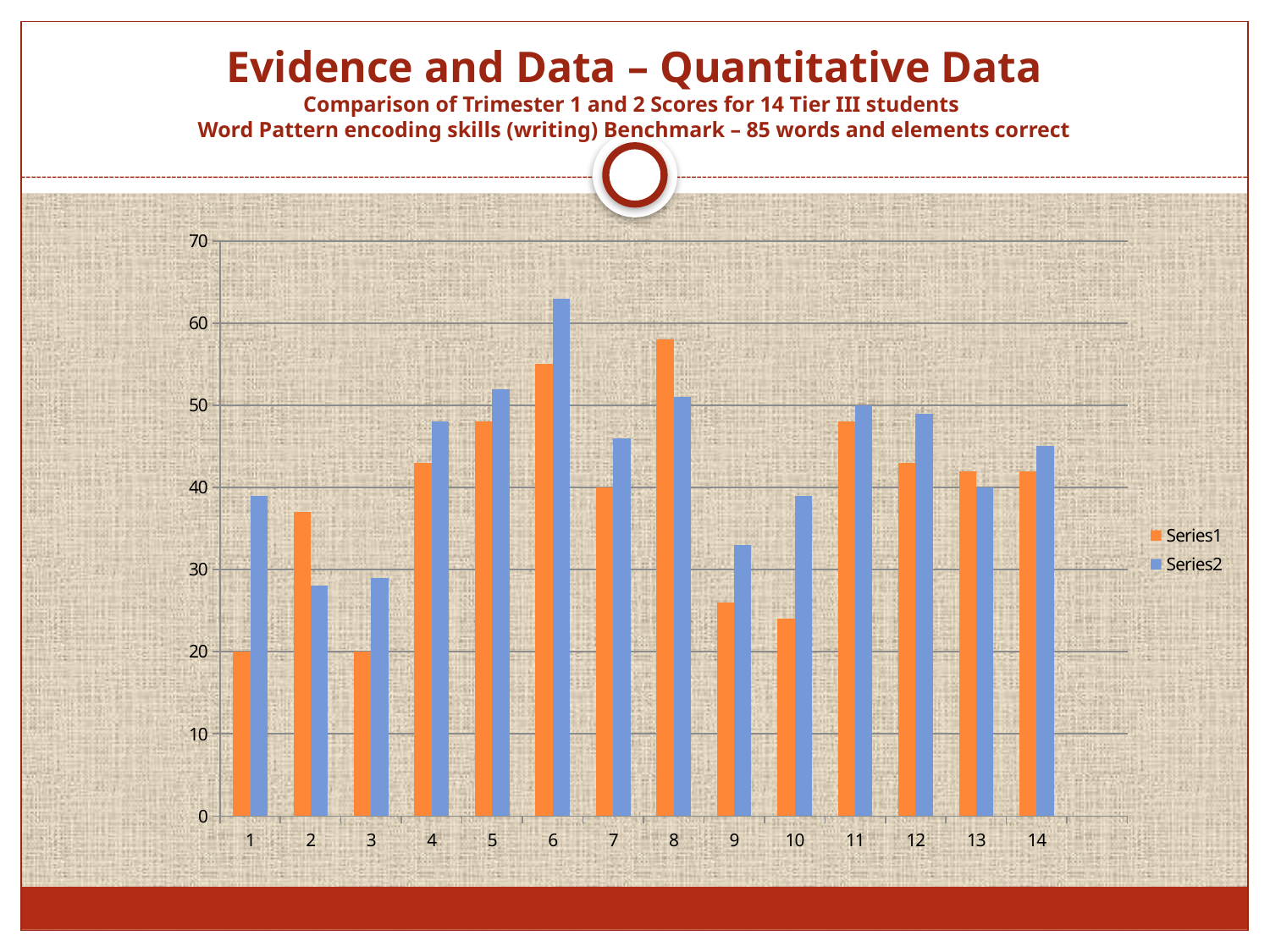
Is the Series2 value for category 6 greater or less than 60? greater How many series does the chart's legend list? 2 What is the Series2 value for category 11? 50 How many categories are shown on the x axis of the chart? 14 What is the Series1 value for category 7? 40 What kind of chart is shown on the slide? bar chart What is the Series1 value for category 1? 20 What colour are the Series1 bars in the chart? orange For category 1, which is larger, Series1 or Series2? Series2 Is the Series1 value for category 9 greater or less than 30? less Which category has the highest Series2 value? 6 For category 8, which is larger, Series1 or Series2? Series1